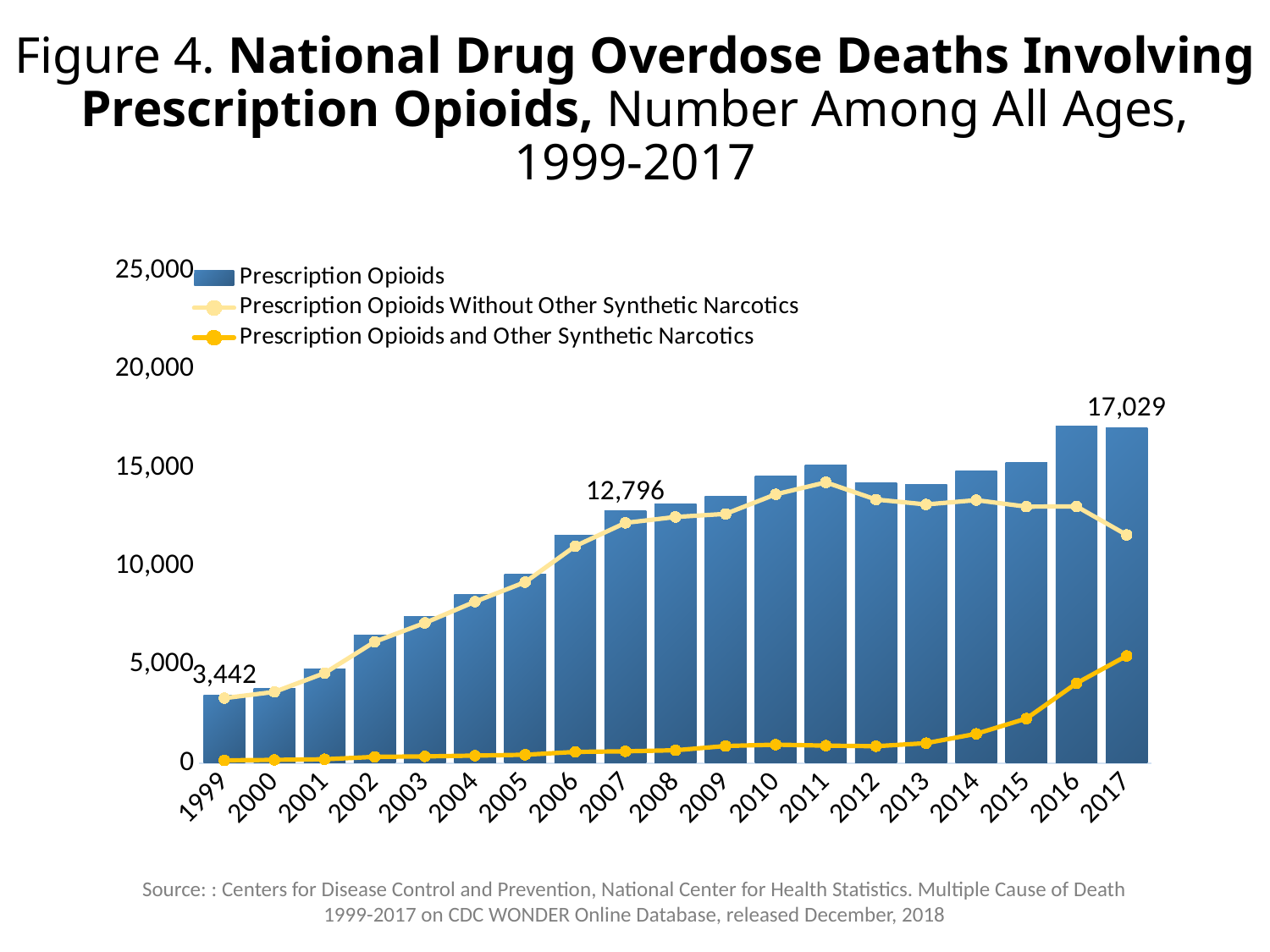
What is the difference between the 2007 and 1999 values for prescription opioid overdose deaths? 9,354 By how much did the number of prescription opioid overdose deaths increase from 1999 to 2017? 13,587 How many series does the legend list? 3 Is the Prescription Opioids bar for 2002 greater or less than 5,000? greater What is the number of prescription opioid overdose deaths shown for 1999? 3,442 What is the difference between the 2017 and 2007 values for prescription opioid overdose deaths? 4,233 How many years are shown along the x axis? 19 Which series is drawn as bars rather than a line? Prescription Opioids What is the number of prescription opioid overdose deaths shown for 2007? 12,796 What is the number of prescription opioid overdose deaths shown for 2017? 17,029 Is the Prescription Opioids bar for 2004 greater or less than 10,000? less Does the Prescription Opioids and Other Synthetic Narcotics line rise or fall from 1999 to 2017? rise